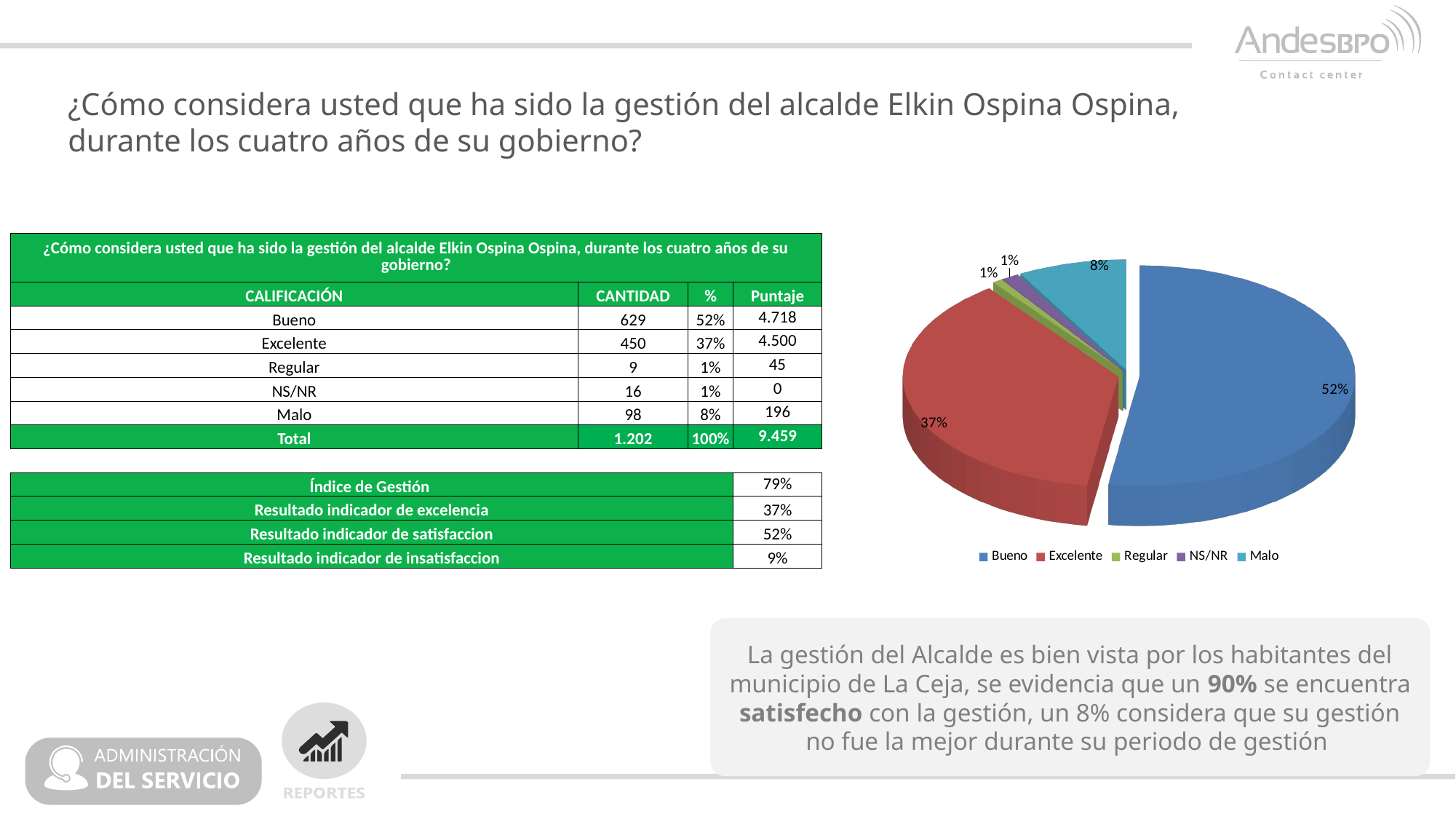
How many categories does the pie chart legend list? 5 What is the difference in percentage points between the Bueno and Excelente slices? 15% What share of the pie does Regular represent? 1% What is the difference in percentage points between the Malo and Regular slices? 7% Which colour is used for the Bueno slice in the pie chart? blue Which slice is larger, Excelente or Malo? Excelente Which category has the largest slice of the pie? Bueno What share of the pie does Excelente represent? 37% What kind of chart is shown on the slide? pie chart What share of the pie does Malo represent? 8% Which legend entry is shown in red? Excelente